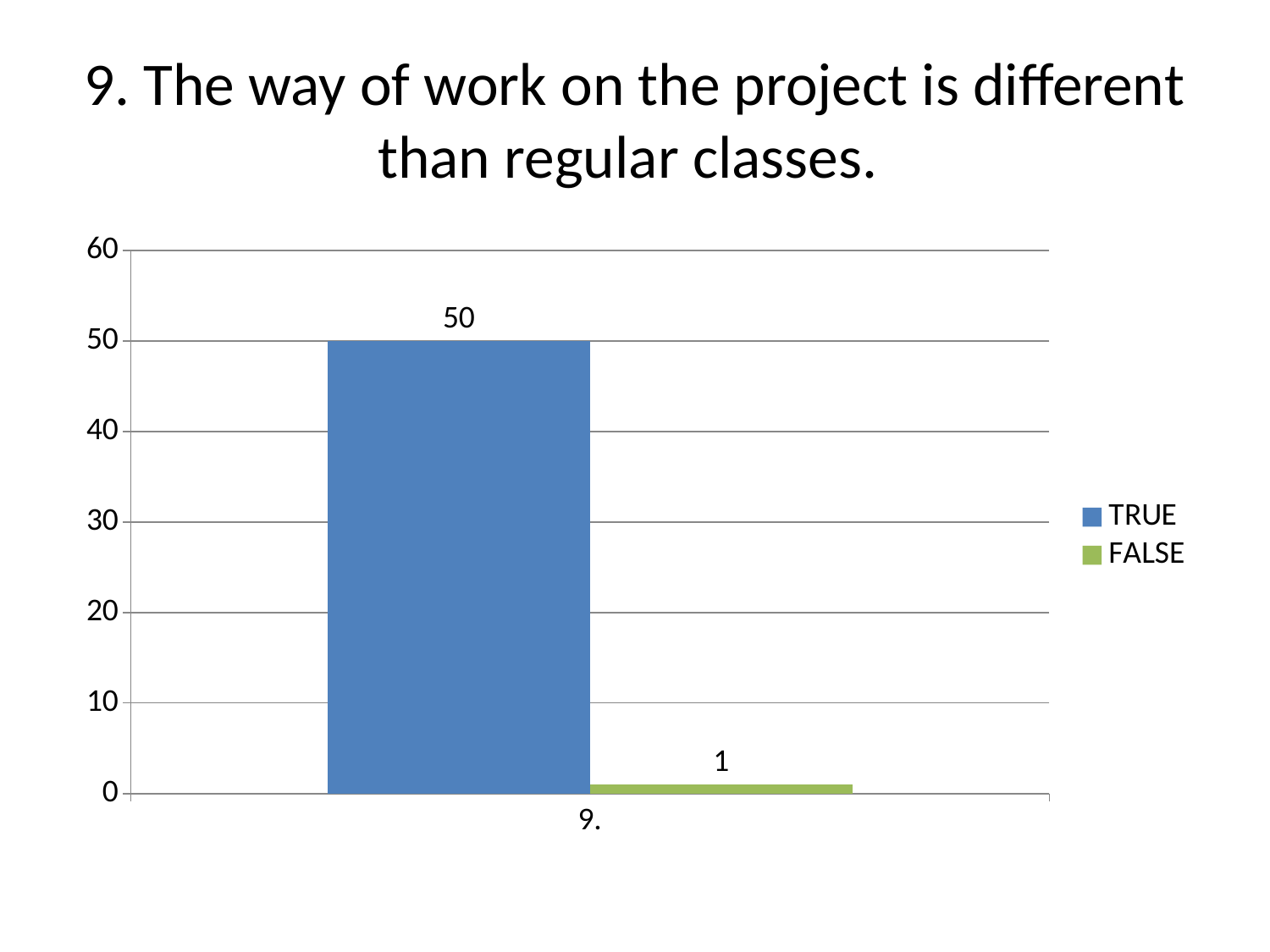
How many series does the legend list? 2 What is the value for TRUE? 50 Is the value for TRUE greater or less than 40? greater What kind of chart is shown on the slide? Bar chart What is the difference between the TRUE and FALSE values? 49 Which series has the lowest value? FALSE Which series has the higher value, TRUE or FALSE? TRUE Is the value for TRUE larger than the value for FALSE? Yes What is the value for FALSE? 1 Is the value for FALSE greater or less than 10? less What is the category label shown on the x axis? 9. What is the total of the TRUE and FALSE values? 51